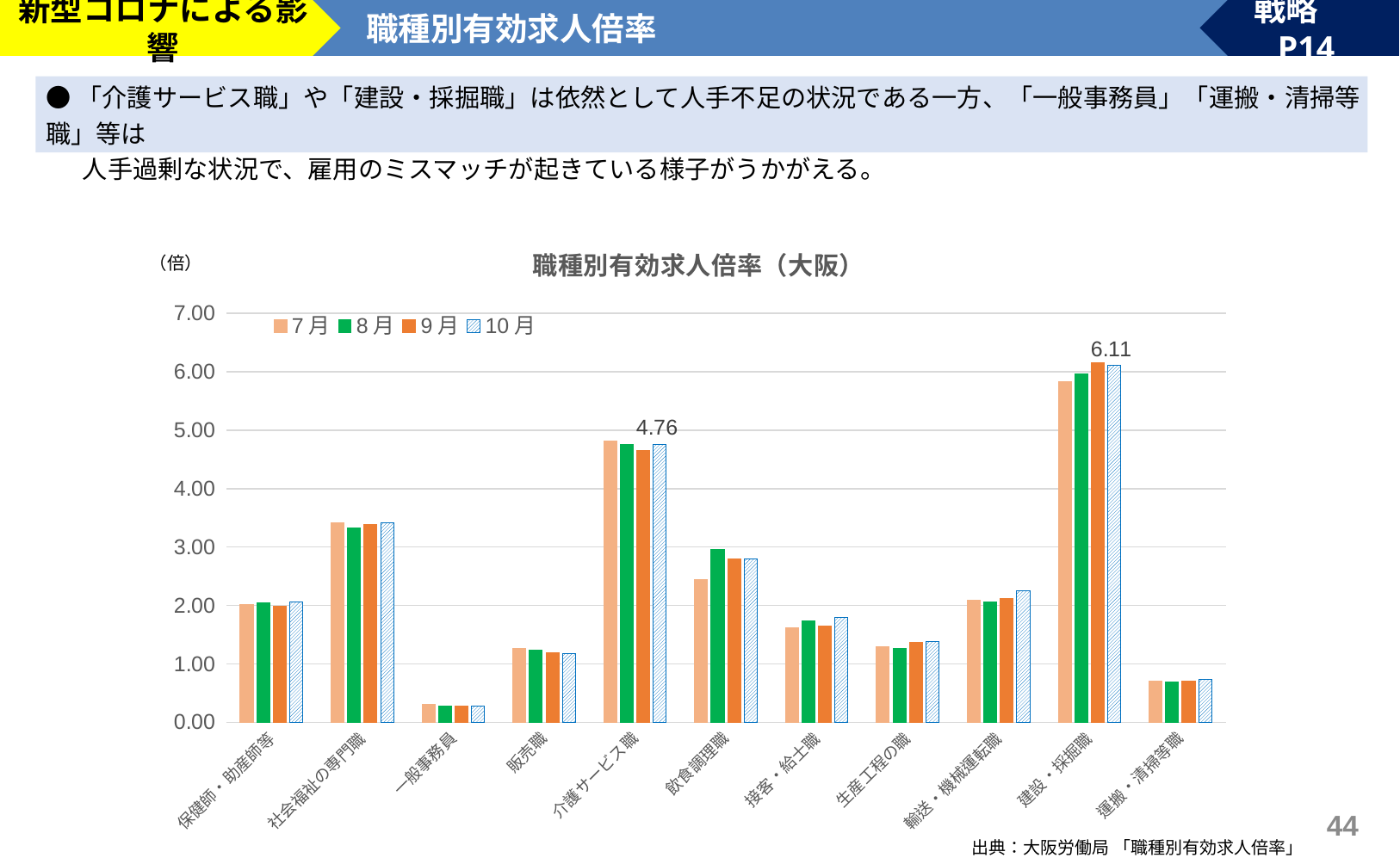
How many series does the legend of the chart list? 4 Are the values for 社会福祉の専門職 greater or less than 3.00? greater What kind of chart is shown on the slide? bar chart How many occupation categories are shown on the x axis of the chart? 11 Which category has higher values, 介護サービス職 or 飲食調理職? 介護サービス職 What is the difference between the labeled value for 建設・採掘職 (6.11) and the labeled value for 介護サービス職 (4.76)? 1.35 Which occupation category has the highest values in the chart? 建設・採掘職 What value is labeled above the 建設・採掘職 group in the chart? 6.11 What value is labeled above the 介護サービス職 group in the chart? 4.76 What is the title of the chart? 職種別有効求人倍率（大阪） Are the values for 一般事務員 greater or less than 1.00? less Which occupation category has the lowest values in the chart? 一般事務員